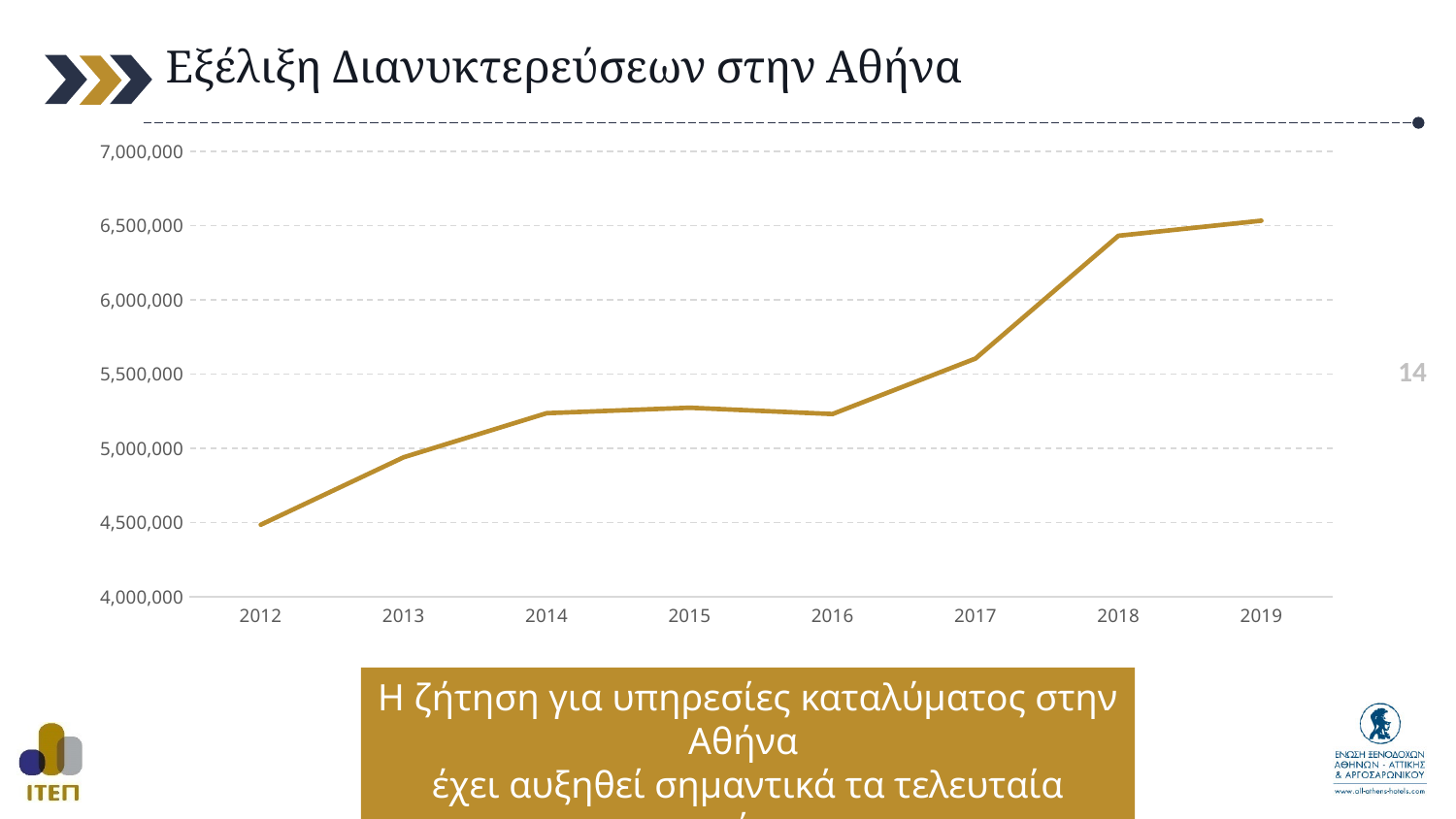
Which year has the larger value, 2017 or 2018? 2018 What is the title of the slide containing the chart? Εξέλιξη Διανυκτερεύσεων στην Αθήνα Is the value for 2016 greater or less than 5,500,000? less Is the value for 2017 greater or less than 5,500,000? greater Is the value for 2012 greater or less than 5,000,000? less How many years are plotted on the x axis of the chart? 8 Which year has the highest value on the chart? 2019 What kind of chart is shown on the slide? line chart Which year has the lowest value on the chart? 2012 Do the values generally rise or fall from 2012 to 2019? rise